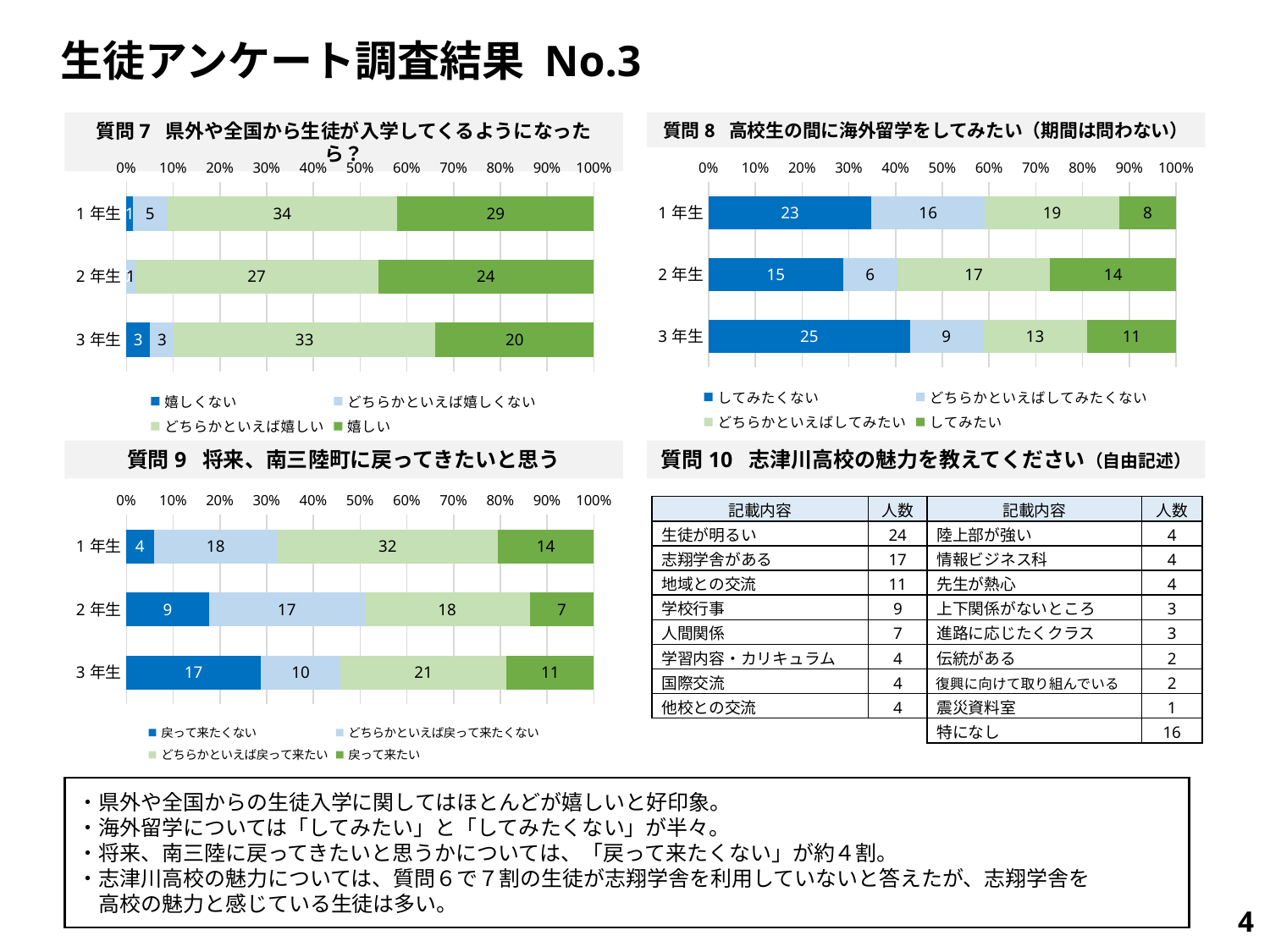
In the 質問8 chart, what is the difference between the してみたくない values for 3年生 and 2年生? 10 In the 質問8 chart, what is the total of all segments in the 2年生 bar? 52 In the 質問9 chart, what is the total of all segments in the 1年生 bar? 68 In the 質問9 chart, what is the value for 3年生 in the 戻って来たくない series? 17 In the 質問7 chart, which grade has the larger 嬉しい value, 1年生 or 3年生? 1年生 How many series does the legend of the 質問9 chart list? 4 What kind of chart is the 質問8 chart? Stacked bar chart In the 質問9 chart, what is the value for 2年生 in the どちらかといえば戻って来たい series? 18 In the 質問8 chart, what is the value for 1年生 in the してみたくない series? 23 In the 質問9 chart, which grade has the lowest value in the 戻って来たくない series? 1年生 In the 質問8 chart, which grade has the highest value in the してみたい series? 2年生 In the 質問7 chart, what is the value for 3年生 in the 嬉しい series? 20